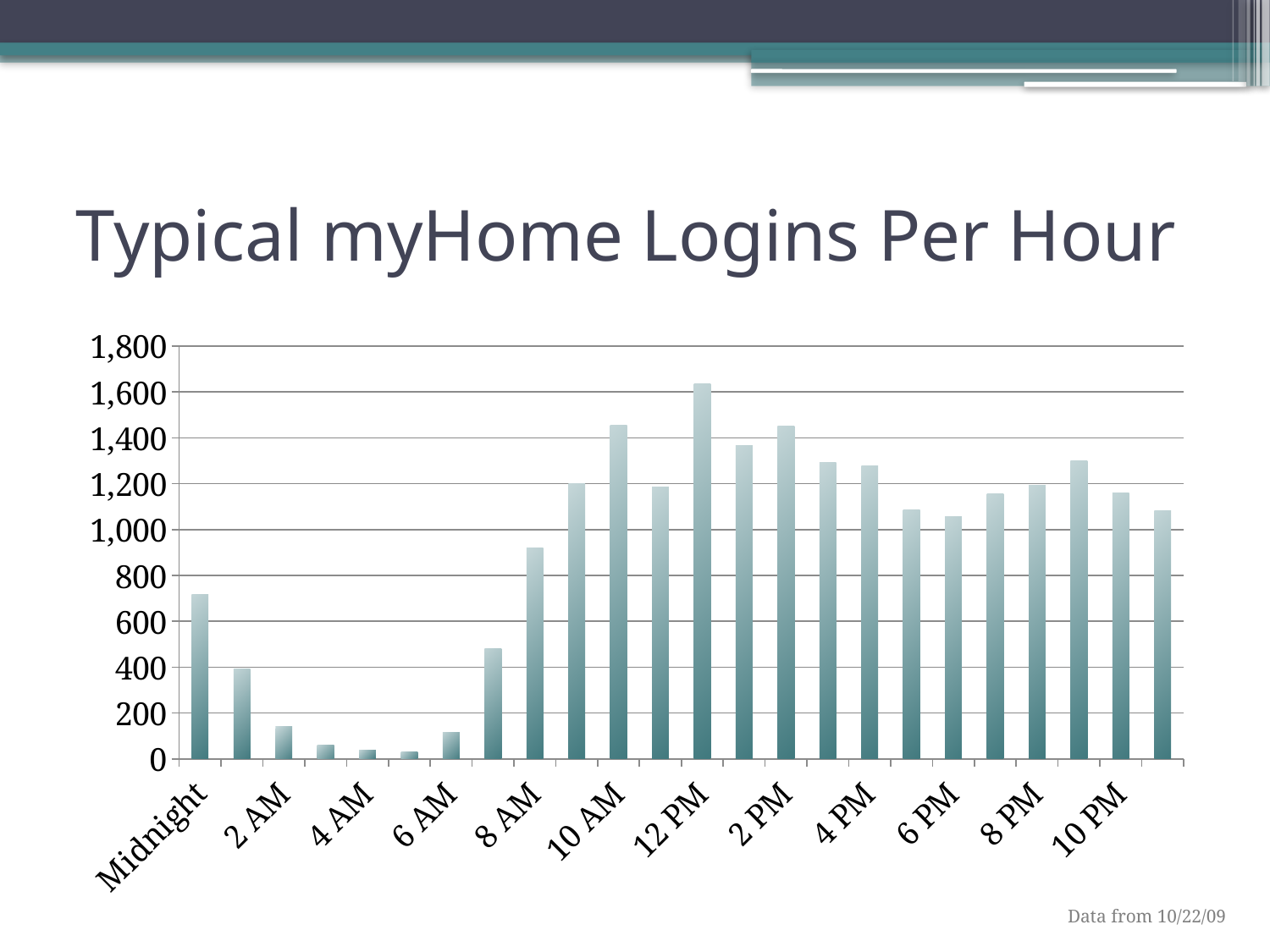
What kind of chart is shown on the slide? bar chart Which has more logins, 12 PM or 8 PM? 12 PM Is the value for Midnight greater or less than 600? greater Which hour has the highest number of logins? 12 PM What is the title of the chart? Typical myHome Logins Per Hour Which has more logins, Midnight or 2 AM? Midnight How many bars are plotted in the chart? 24 Is the value for 10 AM greater or less than 1,400? greater Do the values rise or fall from Midnight to 4 AM? fall Is the value for 2 AM greater or less than 200? less According to the note under the chart, what date is the data from? 10/22/09